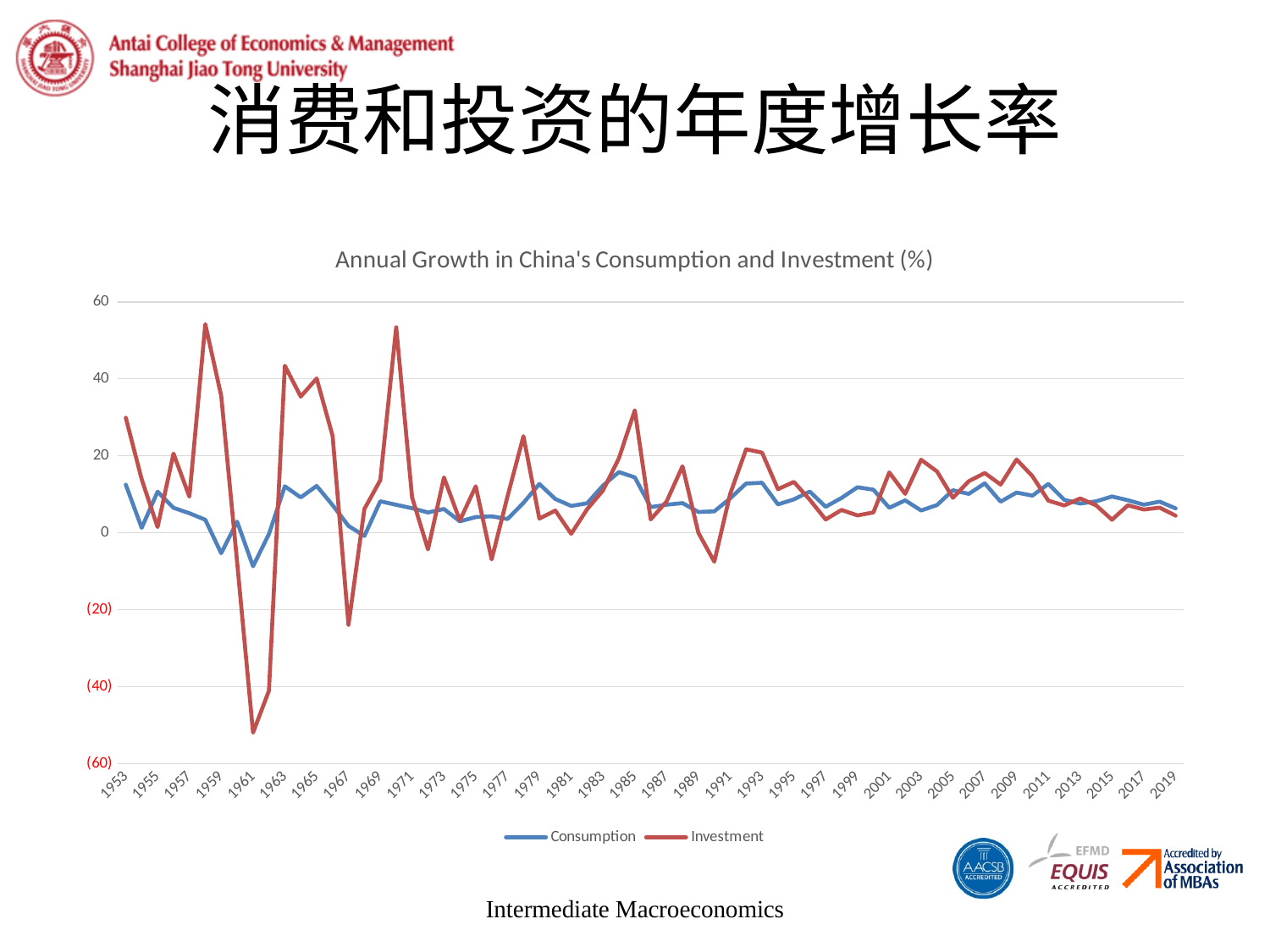
Is the Investment value for 1970 greater or less than 40? greater Is the Consumption value for 1961 greater or less than 0? less In 1961, which is larger, Consumption or Investment? Consumption Is the Investment value for 1961 greater or less than (40)? less In which year does the Investment line reach its lowest point? 1961 What type of chart is shown on the slide? Line chart What is the title of the chart? Annual Growth in China's Consumption and Investment (%) Which colour is used for the Investment line? Red How many series does the legend list? 2 Which series reaches the lowest value anywhere on the chart? Investment